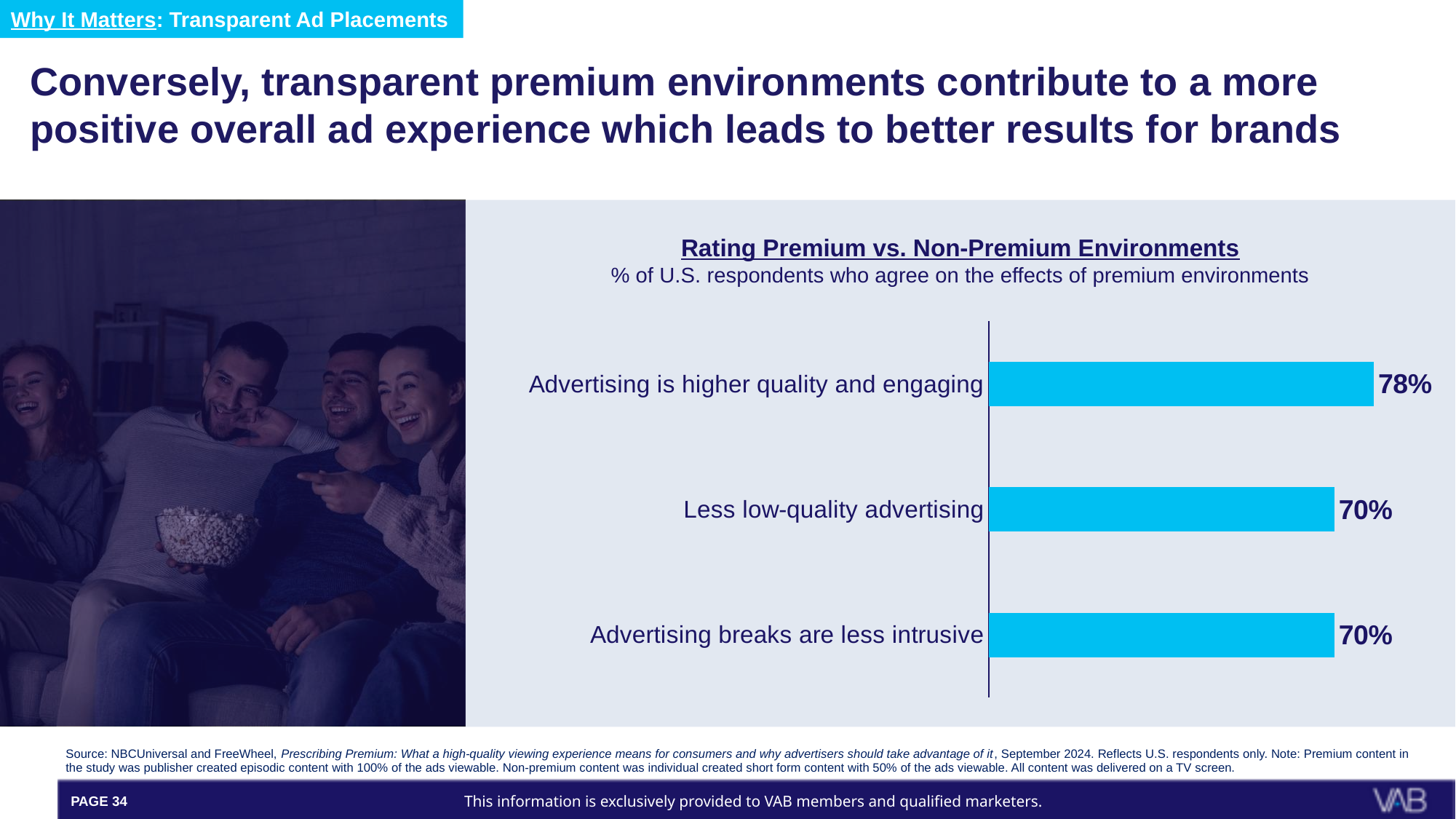
Which category has the highest percentage of respondents agreeing? Advertising is higher quality and engaging What does the chart subtitle say the values represent? % of U.S. respondents who agree on the effects of premium environments What is the title of the chart? Rating Premium vs. Non-Premium Environments What kind of chart is shown on the slide? Bar chart What is the value for 'Less low-quality advertising'? 70% How many categories are shown in the chart? 3 What is the value for 'Advertising breaks are less intrusive'? 70% What percentage of U.S. respondents agree that advertising is higher quality and engaging in premium environments? 78% Which is larger: the value for 'Advertising is higher quality and engaging' or the value for 'Advertising breaks are less intrusive'? Advertising is higher quality and engaging Do 'Less low-quality advertising' and 'Advertising breaks are less intrusive' have the same value? Yes What is the difference between the value for 'Advertising is higher quality and engaging' and the value for 'Less low-quality advertising'? 8%